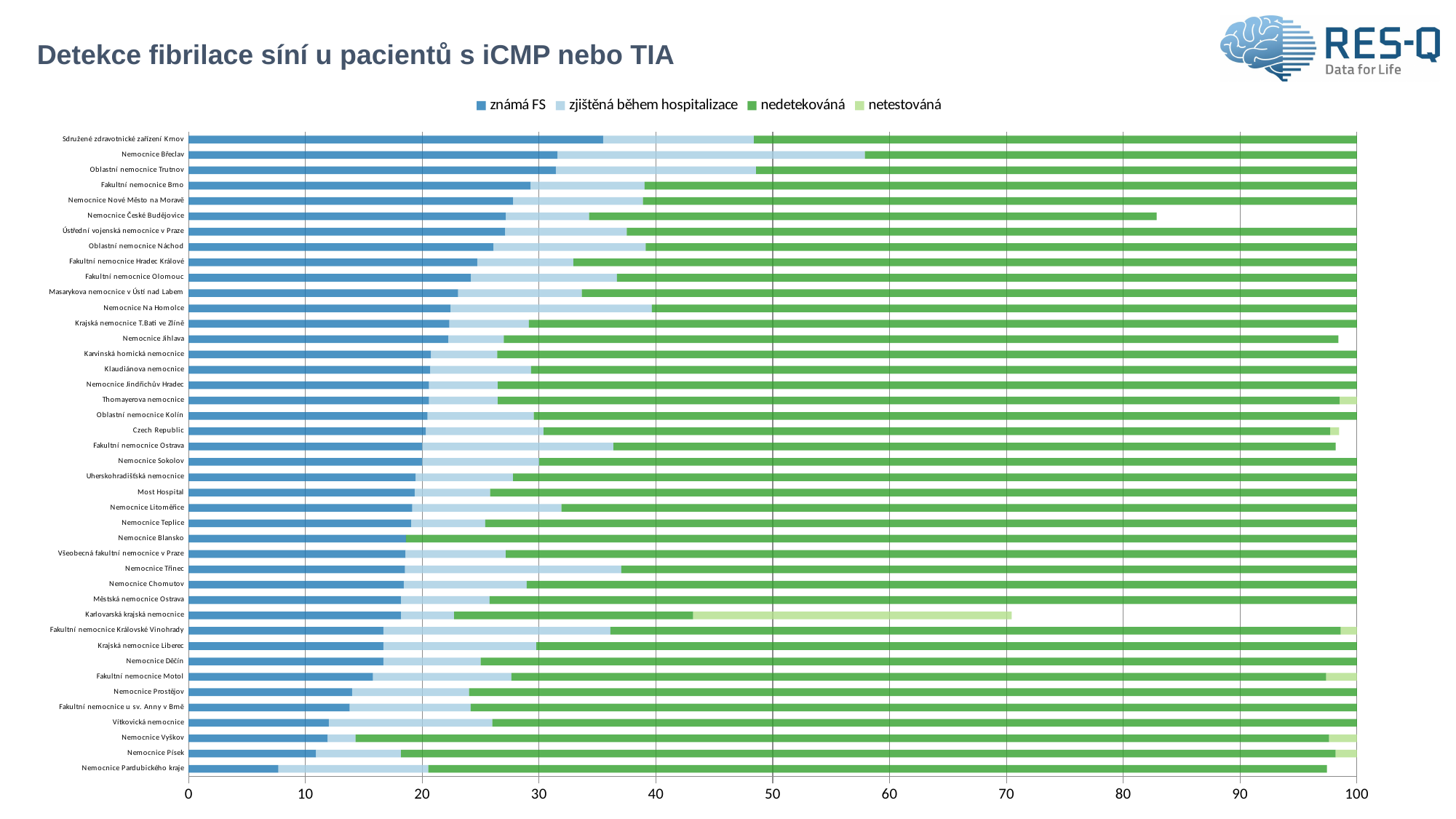
Which category has the lowest value for 'známá FS'? Nemocnice Pardubického kraje Is the total length of the stacked bar for Karlovarská krajská nemocnice greater or less than 80? less Which category has the largest 'netestováná' segment? Karlovarská krajská nemocnice How many hospitals (categories) are plotted on the chart? 42 Is the 'známá FS' value for Sdružené zdravotnické zařízení Krnov greater or less than 30? greater Is the 'známá FS' value for Nemocnice Pardubického kraje greater or less than 10? less Do the 'známá FS' values rise or fall going from the top category to the bottom category? fall What is the title of the chart? Detekce fibrilace síní u pacientů s iCMP nebo TIA Which category has the highest value for 'známá FS'? Sdružené zdravotnické zařízení Krnov How many series does the legend list? 4 Which has a larger 'známá FS' value, Sdružené zdravotnické zařízení Krnov or Nemocnice Břeclav? Sdružené zdravotnické zařízení Krnov What kind of chart is shown on the slide? stacked bar chart